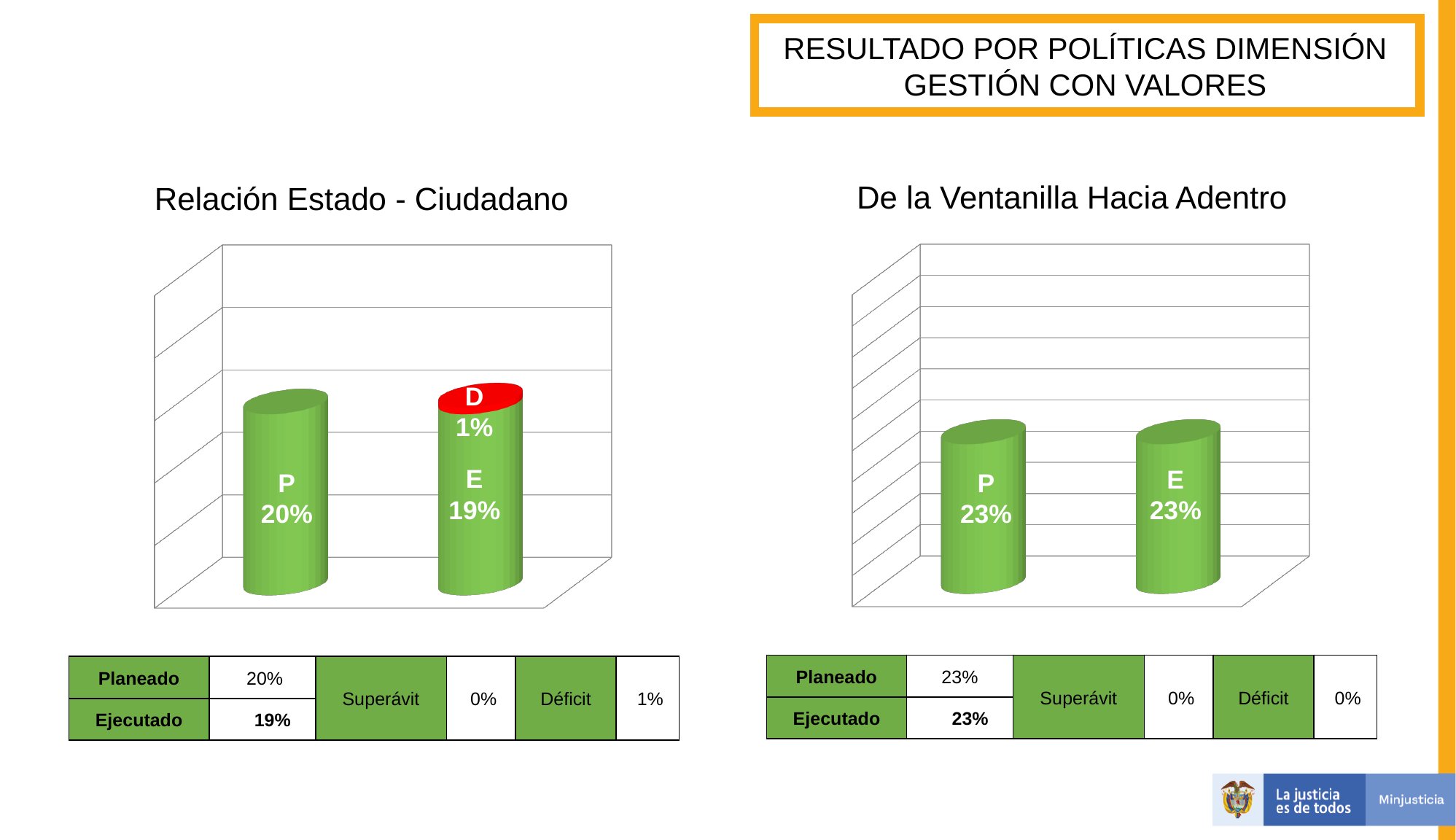
In the 'Relación Estado - Ciudadano' chart, which is larger, the P value or the E value? P In the 'De la Ventanilla Hacia Adentro' chart, what is the value labelled E? 23% In the 'Relación Estado - Ciudadano' chart, what is the total of the stacked bar made up of E and D? 20% In the 'Relación Estado - Ciudadano' chart, what is the value labelled E? 19% In the 'Relación Estado - Ciudadano' chart, what colour is the segment labelled D? Red In the 'Relación Estado - Ciudadano' chart, what is the difference between the P value and the E value? 1% How many bars are plotted in the 'De la Ventanilla Hacia Adentro' chart? 2 In the 'Relación Estado - Ciudadano' chart, what is the value of the red segment labelled D? 1% What kind of chart is the 'Relación Estado - Ciudadano' chart? Bar chart In the 'De la Ventanilla Hacia Adentro' chart, what is the difference between the P value and the E value? 0% In the 'De la Ventanilla Hacia Adentro' chart, what is the value labelled P? 23% In the 'Relación Estado - Ciudadano' chart, what is the value labelled P? 20%